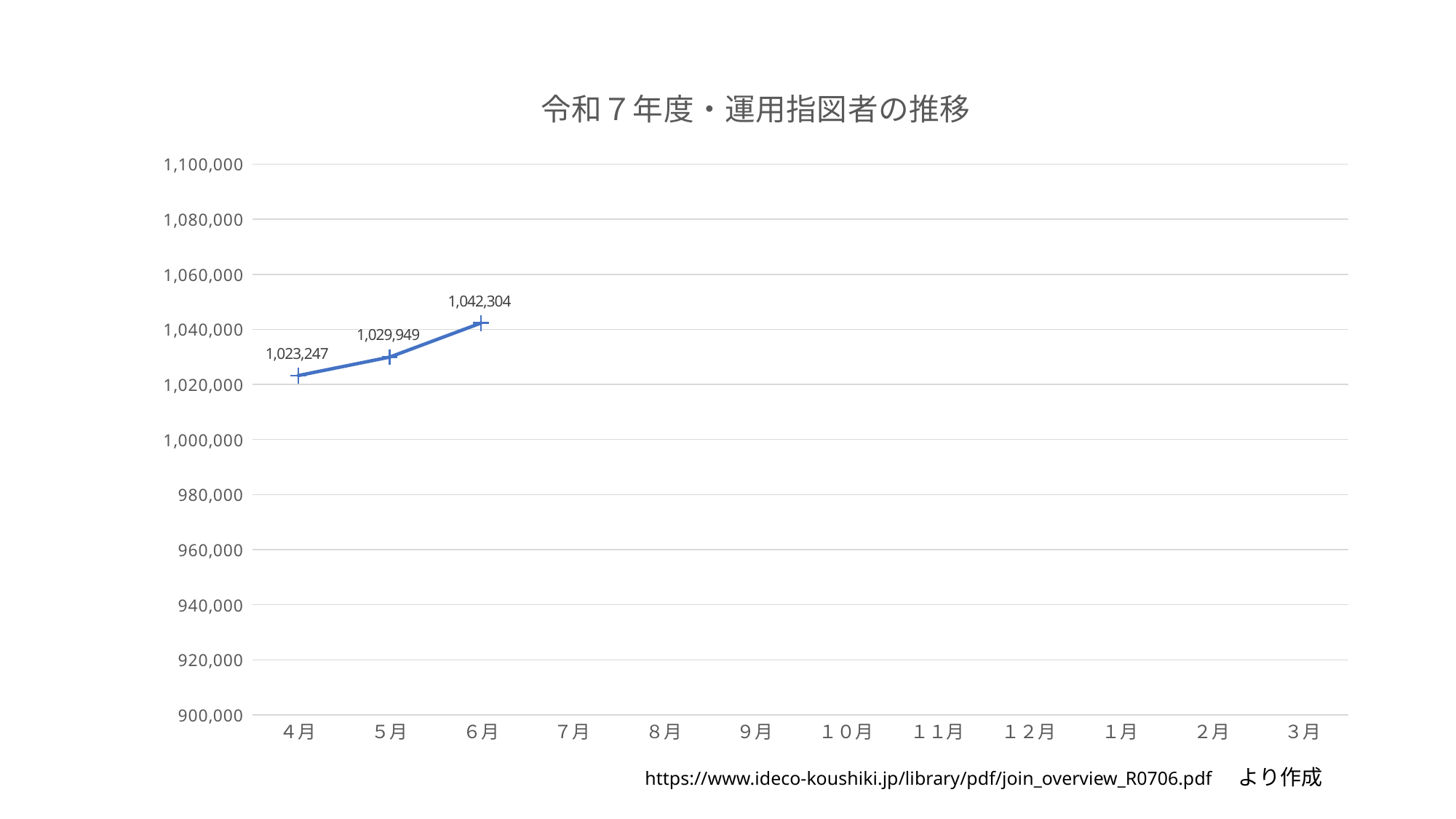
What kind of chart is this? line chart Which month has the highest plotted value? 6月 Is the value for 6月 greater or less than 1,040,000? greater Which is larger, the value for 5月 or the value for 4月? 5月 What is the difference between the values for 6月 and 5月? 12,355 What is the value for 5月? 1,029,949 What is the value for 6月? 1,042,304 What is the difference between the values for 6月 and 4月? 19,057 Which month has the lowest plotted value? 4月 How many data points are plotted on the line? 3 What is the value for 4月? 1,023,247 Do the plotted values rise or fall from 4月 to 6月? rise